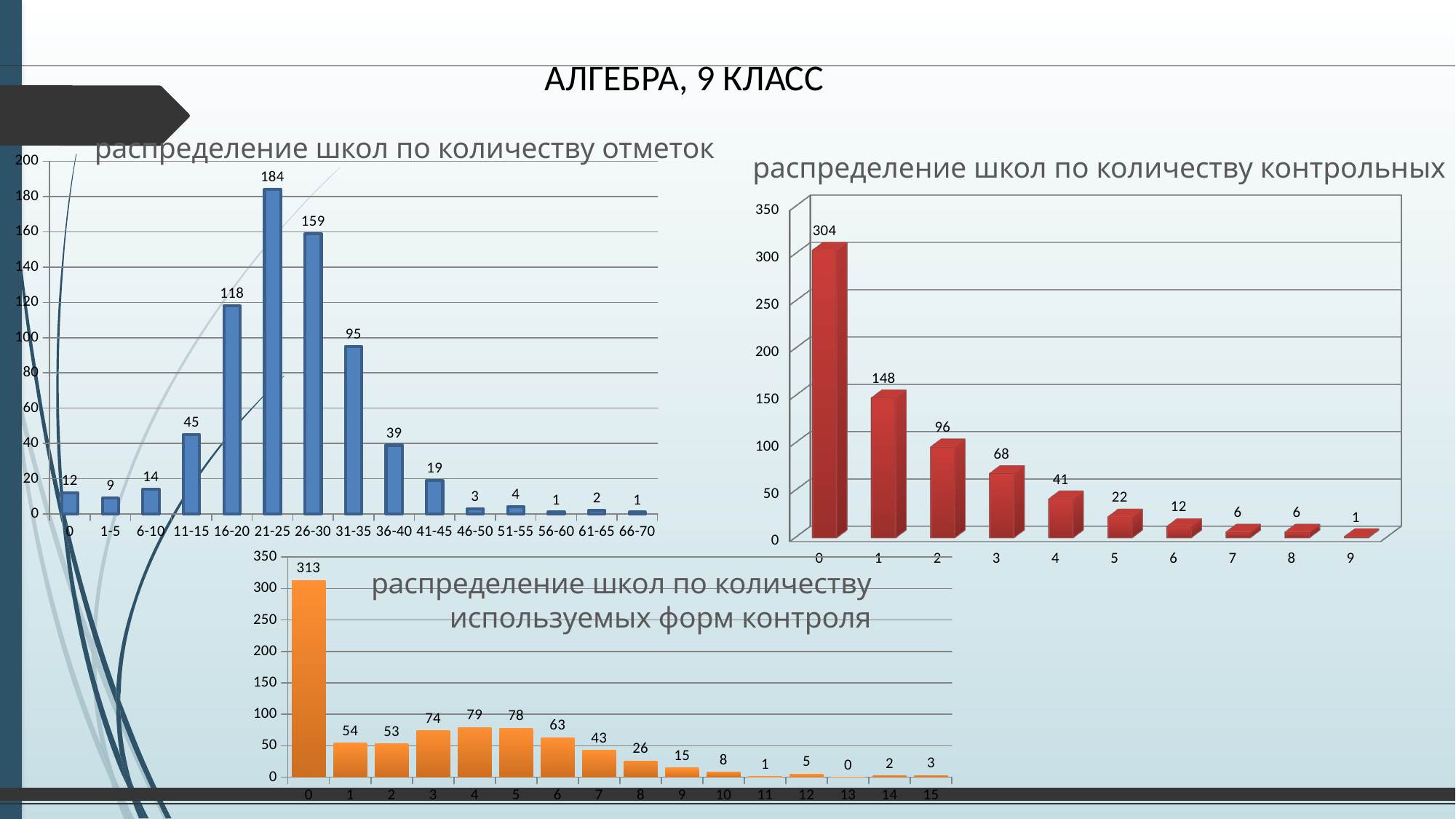
In the chart 'распределение школ по количеству отметок', what is the difference between the values for 26-30 and 31-35? 64 How many categories are shown on the x axis of the chart 'распределение школ по количеству используемых форм контроля'? 16 In the chart 'распределение школ по количеству контрольных', which category has the lowest value? 9 How many categories are shown on the x axis of the chart 'распределение школ по количеству отметок'? 15 In the chart 'распределение школ по количеству отметок', which category has the highest value? 21-25 In the chart 'распределение школ по количеству используемых форм контроля', what is the value for category 4? 79 In the chart 'распределение школ по количеству отметок', what is the value for the category 21-25? 184 In the chart 'распределение школ по количеству контрольных', what is the value for category 0? 304 What colour are the bars in the chart 'распределение школ по количеству используемых форм контроля'? orange What type of chart is 'распределение школ по количеству контрольных'? bar chart In the chart 'распределение школ по количеству контрольных', do the values rise or fall as you move from category 0 to category 9? fall In the chart 'распределение школ по количеству используемых форм контроля', which is larger, the value for category 1 or category 6? category 6